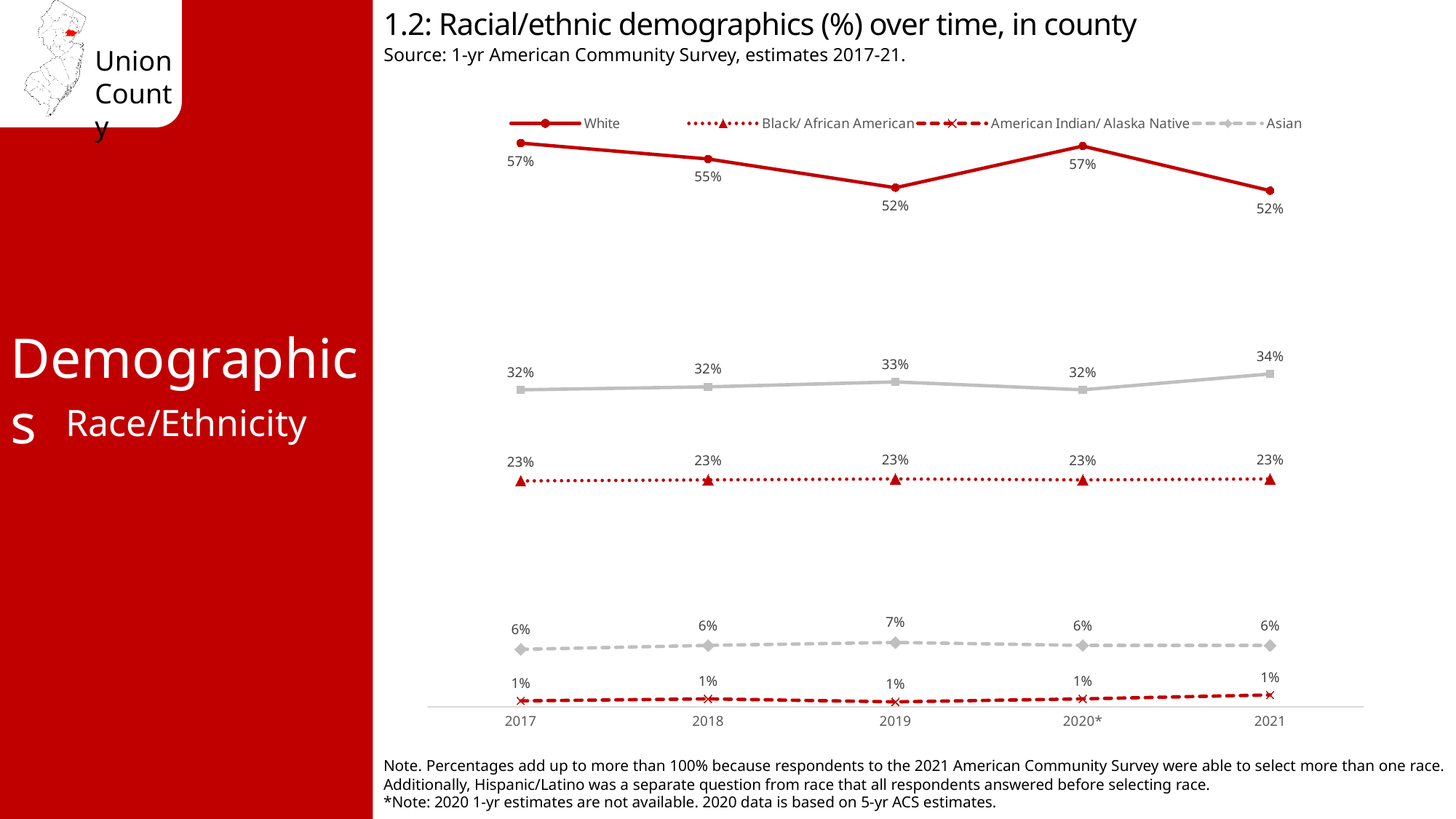
What is the value for Asian in 2019? 7% What is the value for Black/ African American in 2021? 23% How many years are shown on the x axis? 5 What is the value for American Indian/ Alaska Native in 2020*? 1% Which year on the x axis is marked with an asterisk? 2020 What is the difference between the White value in 2017 and in 2019? 5 percentage points Which is larger, the White value in 2018 or in 2020*? 2020* What is the title of the chart? 1.2: Racial/ethnic demographics (%) over time, in county What is the value for White in 2018? 55% In which year is the Asian series at its highest? 2019 What kind of chart is shown on the slide? Line chart Does the White series rise or fall from 2017 to 2019? Fall